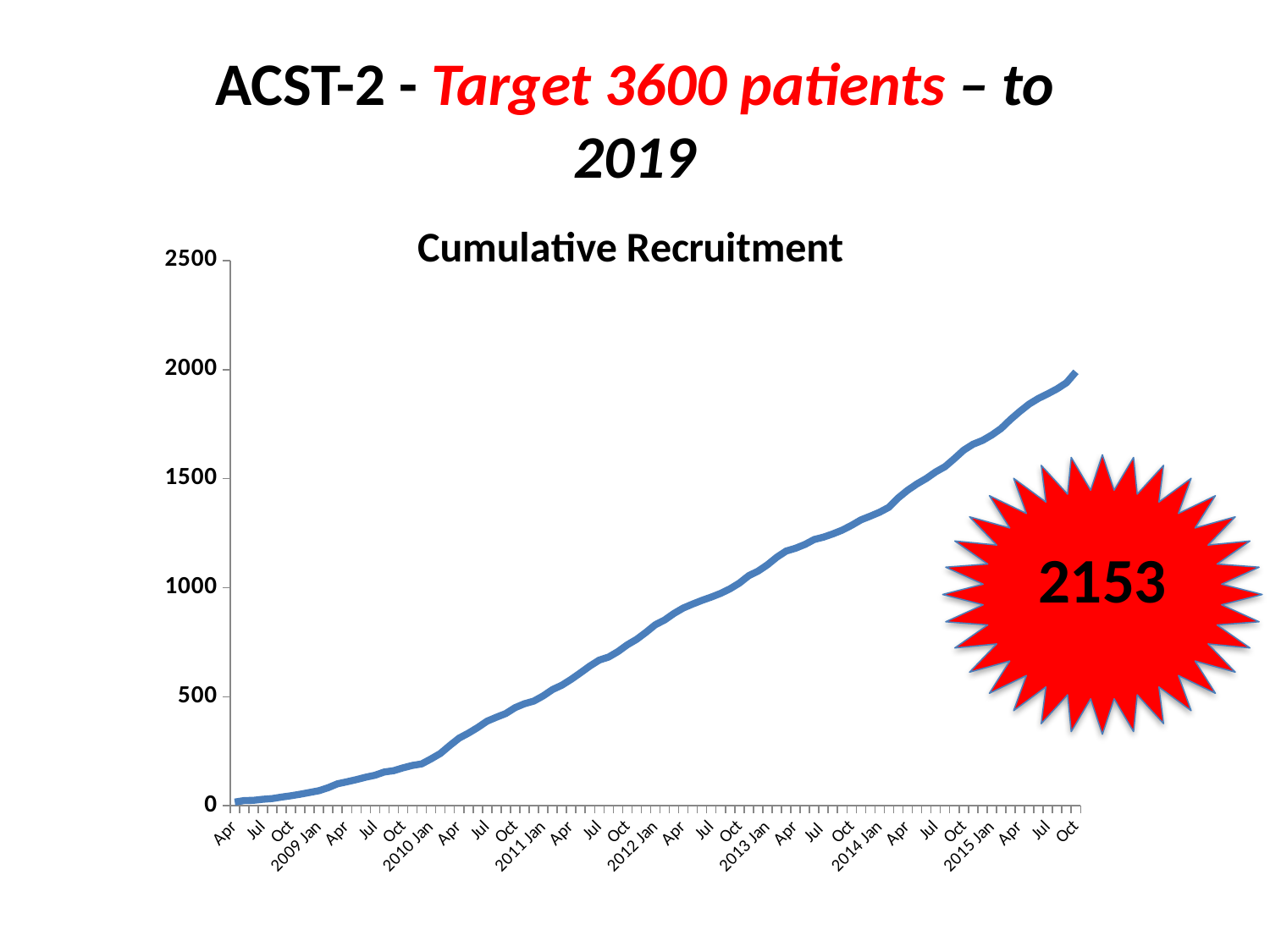
Is the cumulative recruitment value at 2010 Jan greater or less than 500? less Do the values in the Cumulative Recruitment chart rise or fall along the x axis? rise Is the cumulative recruitment value at 2013 Jan greater or less than 1000? greater Which has the larger cumulative recruitment value, 2011 Jan or 2013 Jan? 2013 Jan At which x-axis label is the Cumulative Recruitment line at its lowest value? Apr (the first point) Is the cumulative recruitment value at Oct 2015 greater or less than 1500? greater What is the highest value shown on the y axis of the chart? 2500 What is the title of the chart? Cumulative Recruitment What kind of chart is shown on the slide? line chart At which x-axis label does the Cumulative Recruitment line reach its highest value? Oct (2015)